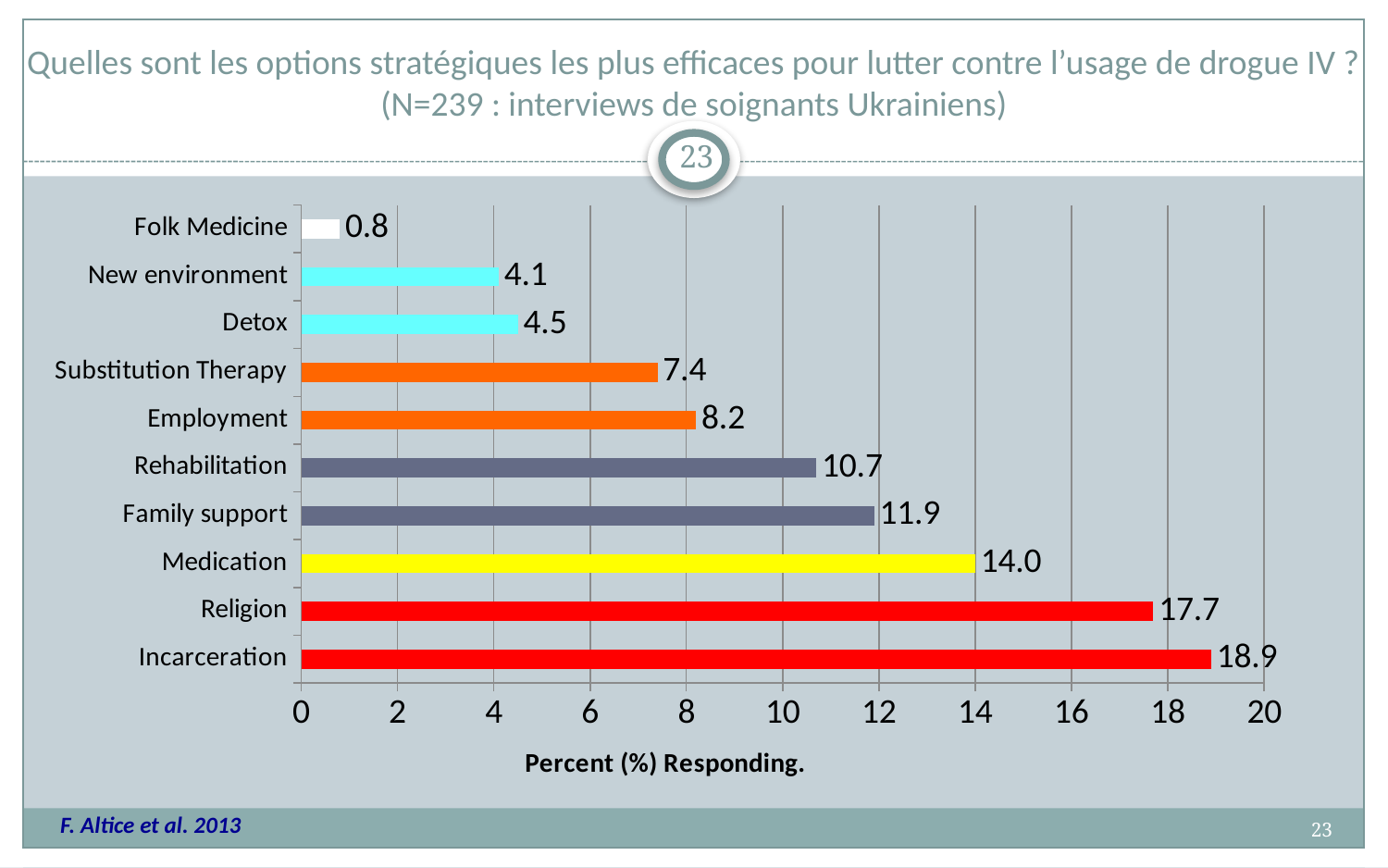
Which is larger, the value for Employment or the value for Substitution Therapy? Employment Which category has the highest value? Incarceration Which category has the lowest value? Folk Medicine Is the value for Religion greater or less than 16? greater How many categories are shown in the chart? 10 What is the value for Folk Medicine? 0.8 What is the value for Medication? 14.0 What is the value for Incarceration? 18.9 What kind of chart is shown on the slide? Bar chart What is the difference between the values for Family support and Rehabilitation? 1.2 What is the label of the horizontal axis? Percent (%) Responding. What is the difference between the values for Incarceration and Religion? 1.2